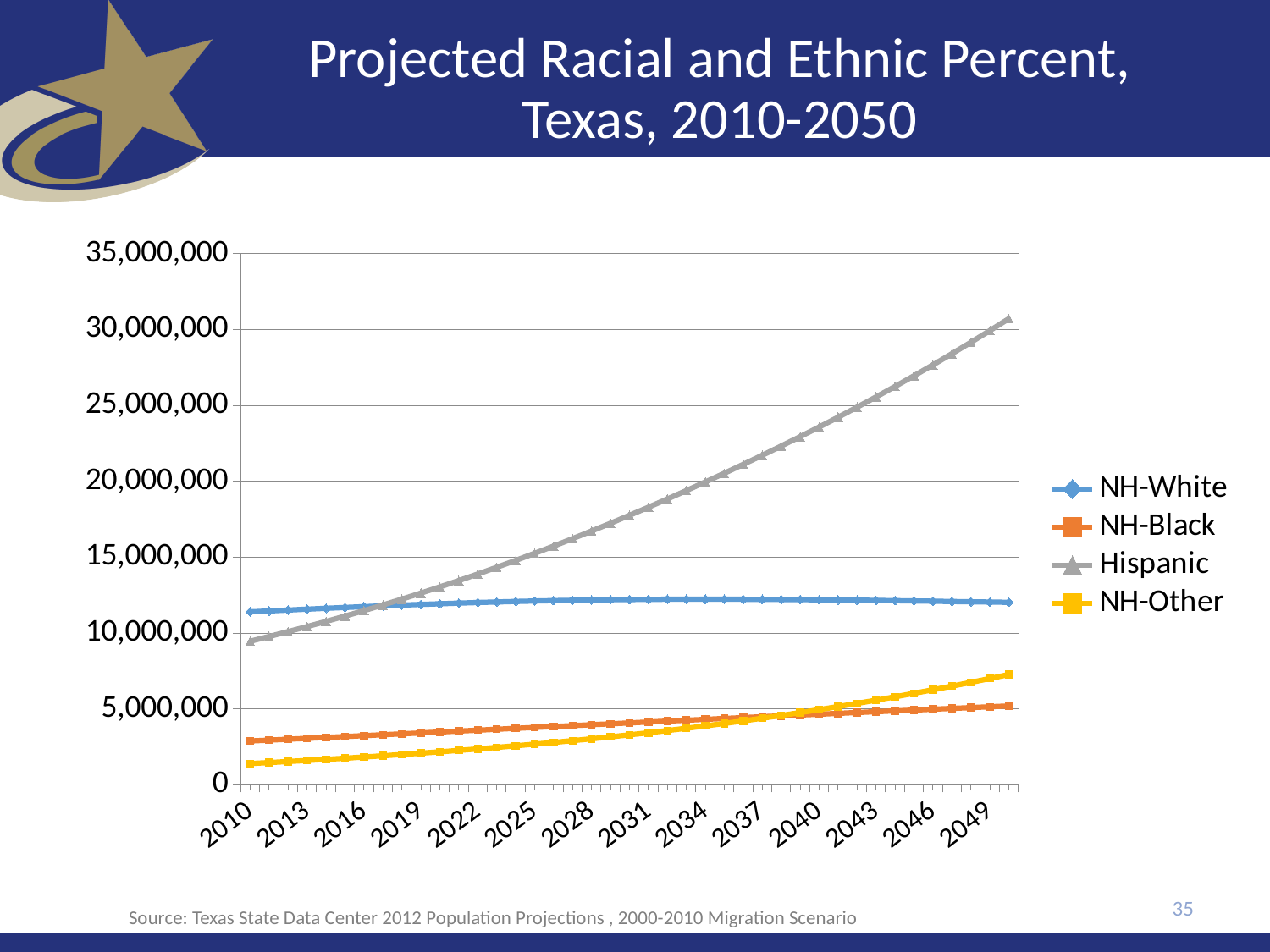
Does the NH-Other series rise or fall from 2010 to 2049? Rise What is the title of the chart on the slide? Projected Racial and Ethnic Percent, Texas, 2010-2050 Is the value for NH-Black in 2010 greater or less than 5,000,000? less In 2010, which is larger: NH-White or Hispanic? NH-White How many series does the legend list? 4 What kind of chart is shown on the slide? Line chart Which series has the highest value in 2049? Hispanic Which series has the lowest value in 2010? NH-Other Is the value for NH-White in 2010 greater or less than 10,000,000? greater Is the value for Hispanic in 2049 greater or less than 25,000,000? greater Does the Hispanic series rise or fall from 2010 to 2049? Rise In 2049, which is larger: NH-Other or NH-Black? NH-Other